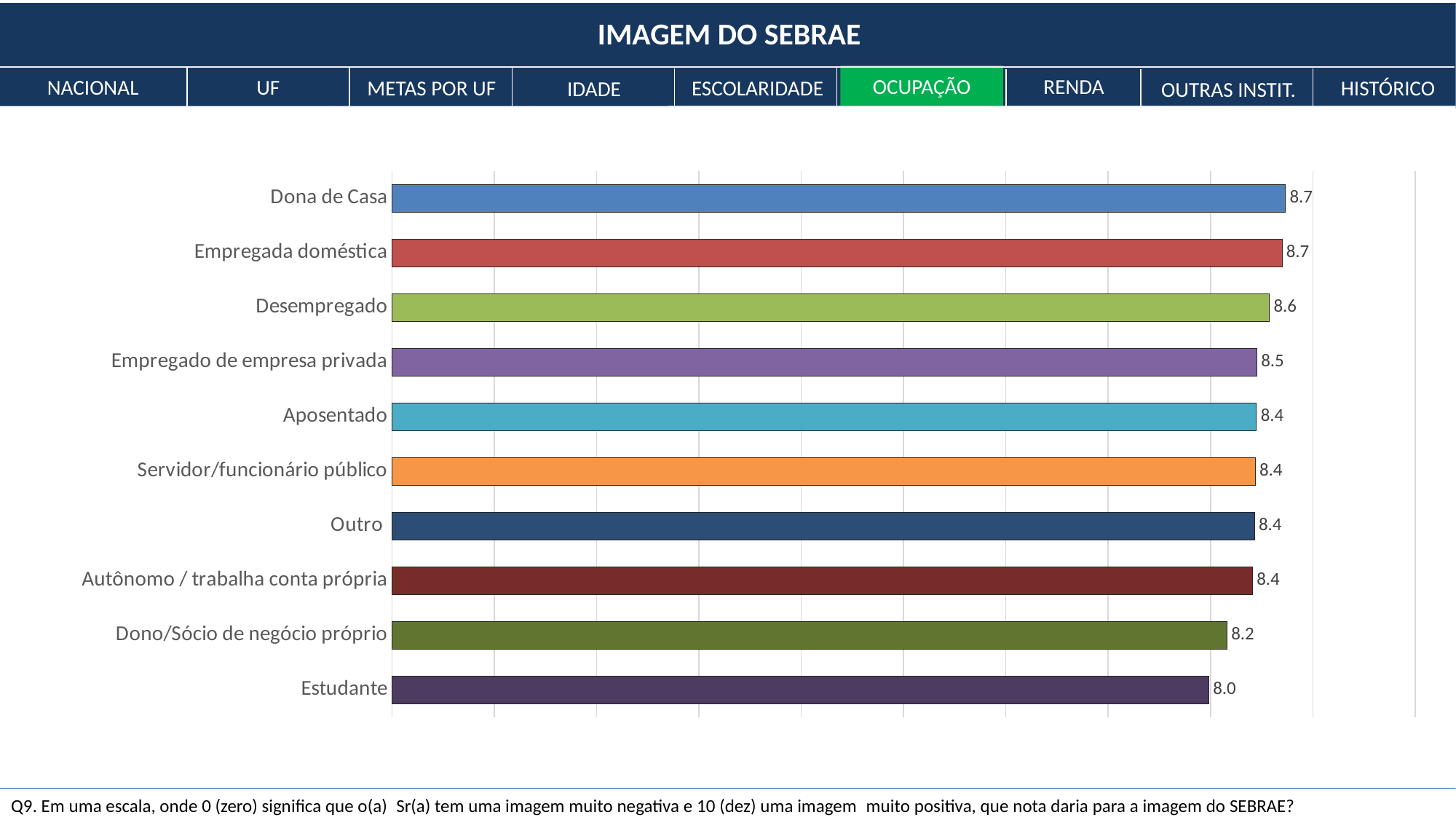
What is the value for Empregado de empresa privada? 8.5 What is the difference between the values for Desempregado and Dono/Sócio de negócio próprio? 0.4 Which is larger, the value for Dono/Sócio de negócio próprio or the value for Empregada doméstica? Empregada doméstica How many categories are shown in the chart? 10 Which is larger, the value for Aposentado or the value for Estudante? Aposentado What is the value for Estudante? 8.0 What is the value for Dono/Sócio de negócio próprio? 8.2 What is the value for Desempregado? 8.6 What kind of chart is shown on the slide? Bar chart Which category has the lowest value? Estudante What is the difference between the values for Dona de Casa and Estudante? 0.7 Which tab in the navigation bar is highlighted in green? OCUPAÇÃO